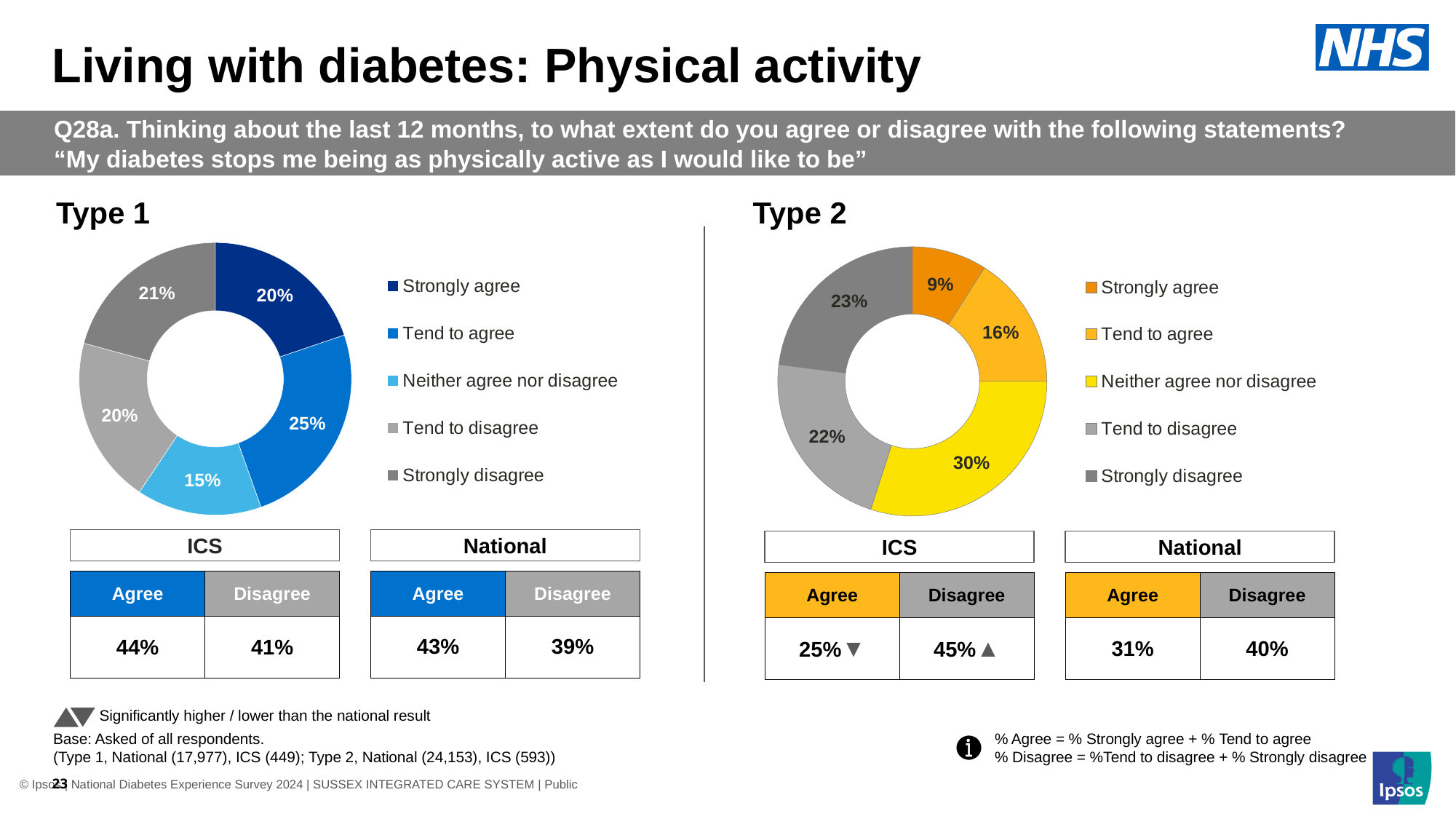
In the Type 2 chart, which response category has the largest share? Neither agree nor disagree In the Type 2 chart, what percentage of respondents said 'Tend to disagree'? 22% In the Type 1 chart, what percentage of respondents said 'Strongly agree'? 20% What kind of chart is used to show the Type 2 results? Donut (pie) chart In the Type 2 chart, which response category has the smallest share? Strongly agree In the Type 2 chart, what percentage of respondents said 'Strongly agree'? 9% In the Type 1 chart, what is the difference in percentage points between 'Tend to agree' and 'Neither agree nor disagree'? 10 In the Type 2 chart, what colour represents 'Neither agree nor disagree'? Yellow In the Type 1 chart, which response category has the largest share? Tend to agree In the Type 2 chart, which is larger: 'Tend to agree' or 'Strongly disagree'? Strongly disagree How many response categories does the legend of the Type 1 chart list? 5 In the Type 1 chart, what percentage of respondents said 'Neither agree nor disagree'? 15%